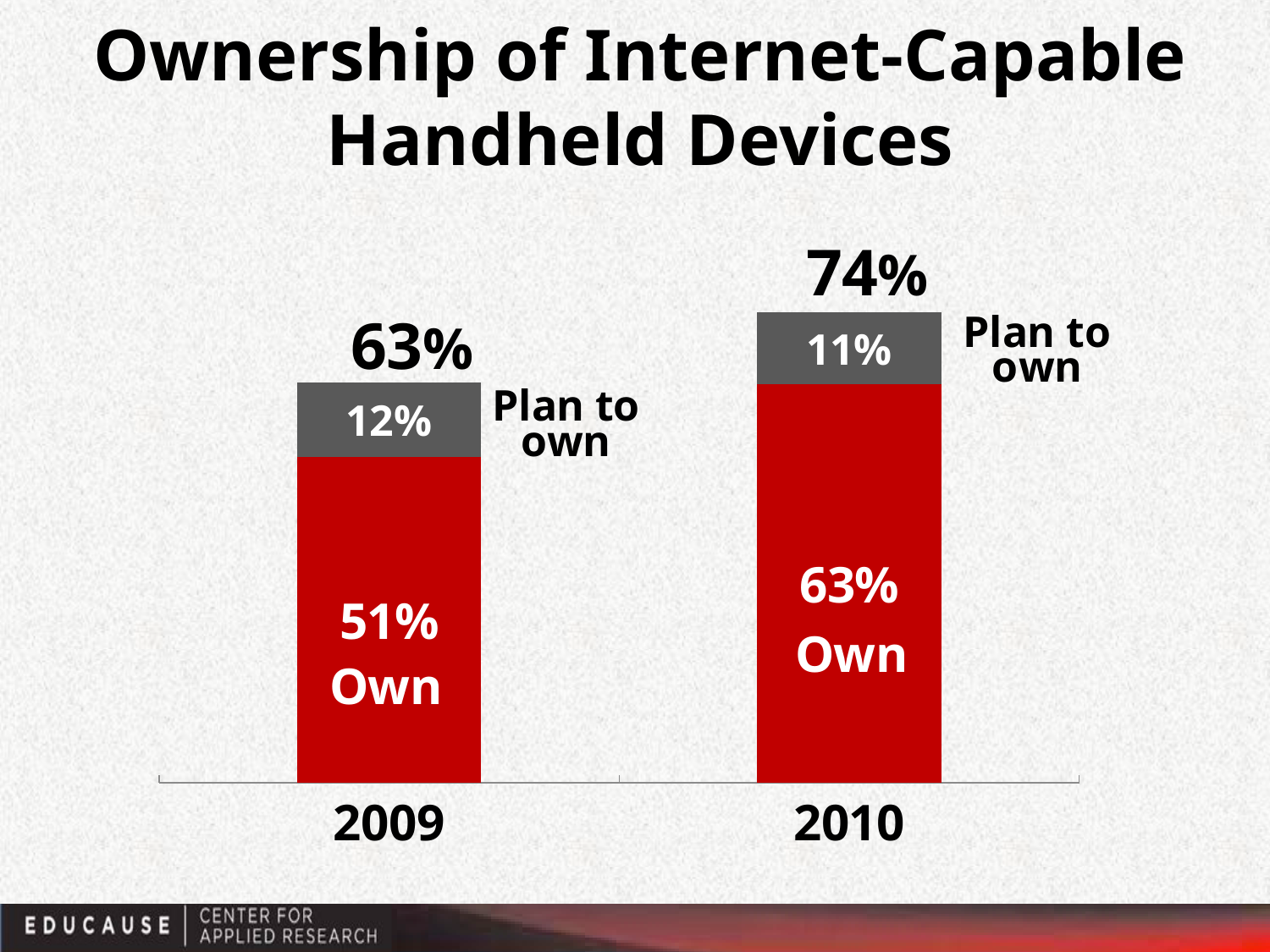
What percentage planned to own an internet-capable handheld device in 2010? 11% What percentage owned an internet-capable handheld device in 2009? 51% What is the total of the stacked bar for 2009? 63% Which year has the higher total (own plus plan to own)? 2010 How many years are shown on the x axis? 2 What percentage owned an internet-capable handheld device in 2010? 63% What is the total of the stacked bar for 2010? 74% By how many percentage points did the 'Own' share increase from 2009 to 2010? 12 Which year has the lower 'Own' percentage? 2009 What kind of chart is shown on the slide? Stacked bar chart Is the 'Plan to own' value larger in 2009 or 2010? 2009 What percentage planned to own an internet-capable handheld device in 2009? 12%